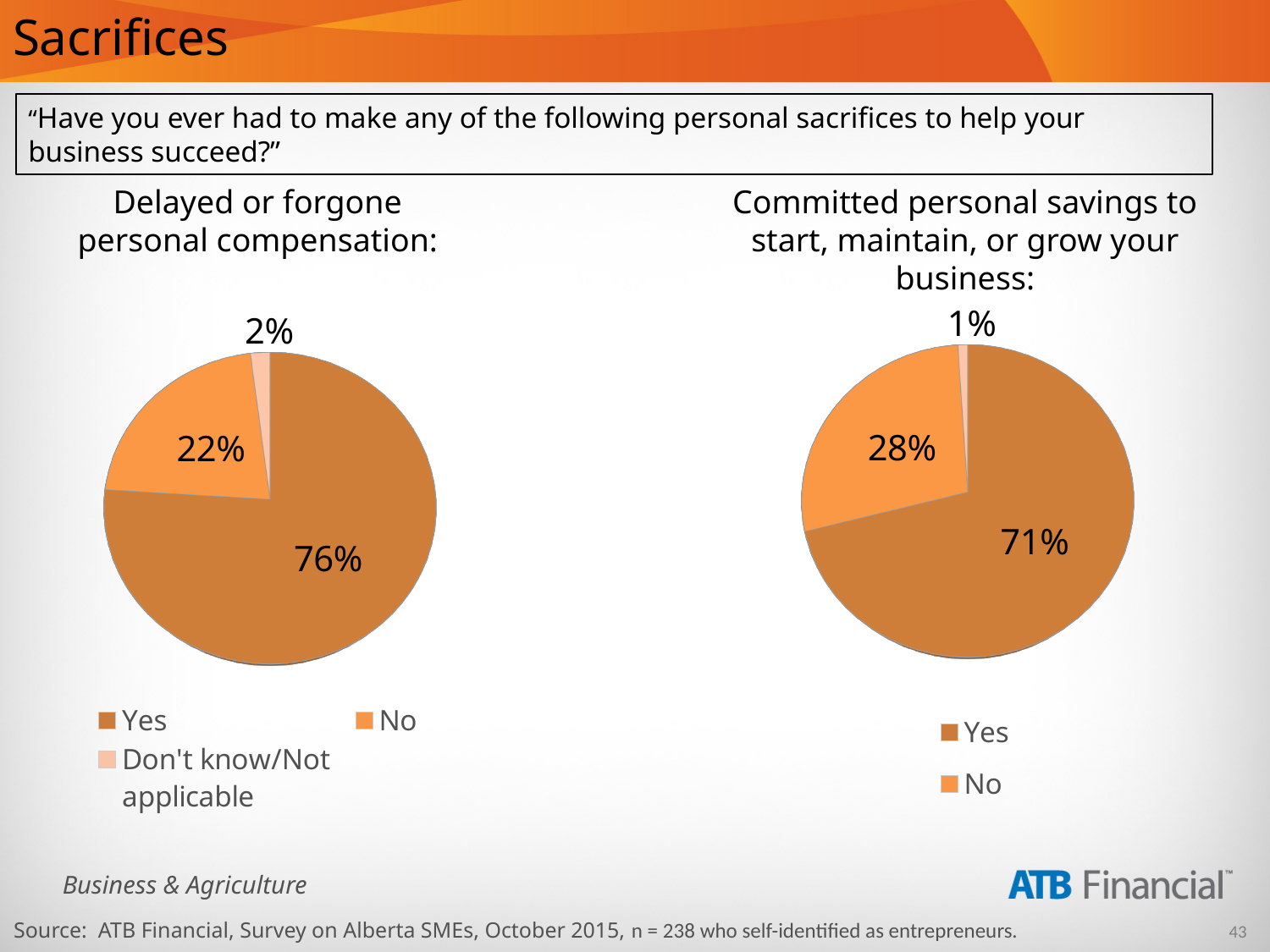
How many entries does the legend of the 'Committed personal savings to start, maintain, or grow your business' chart list? 2 In the 'Committed personal savings to start, maintain, or grow your business' chart, what share of respondents answered No? 28% In the 'Committed personal savings to start, maintain, or grow your business' chart, what share of respondents answered Yes? 71% In the 'Delayed or forgone personal compensation' chart, what share of respondents answered Yes? 76% In the 'Delayed or forgone personal compensation' chart, which response has the largest slice? Yes In the 'Delayed or forgone personal compensation' chart, what is the difference between the Yes and No shares? 54 percentage points In the 'Delayed or forgone personal compensation' chart, what share of respondents answered No? 22% In the 'Delayed or forgone personal compensation' chart, what share is labelled Don't know/Not applicable? 2% What type of chart is used on the left side of the slide? Pie chart In the 'Committed personal savings to start, maintain, or grow your business' chart, which legend entry has the smallest slice? No How many entries does the legend of the 'Delayed or forgone personal compensation' chart list? 3 Which chart has the larger Yes share: 'Delayed or forgone personal compensation' or 'Committed personal savings to start, maintain, or grow your business'? Delayed or forgone personal compensation